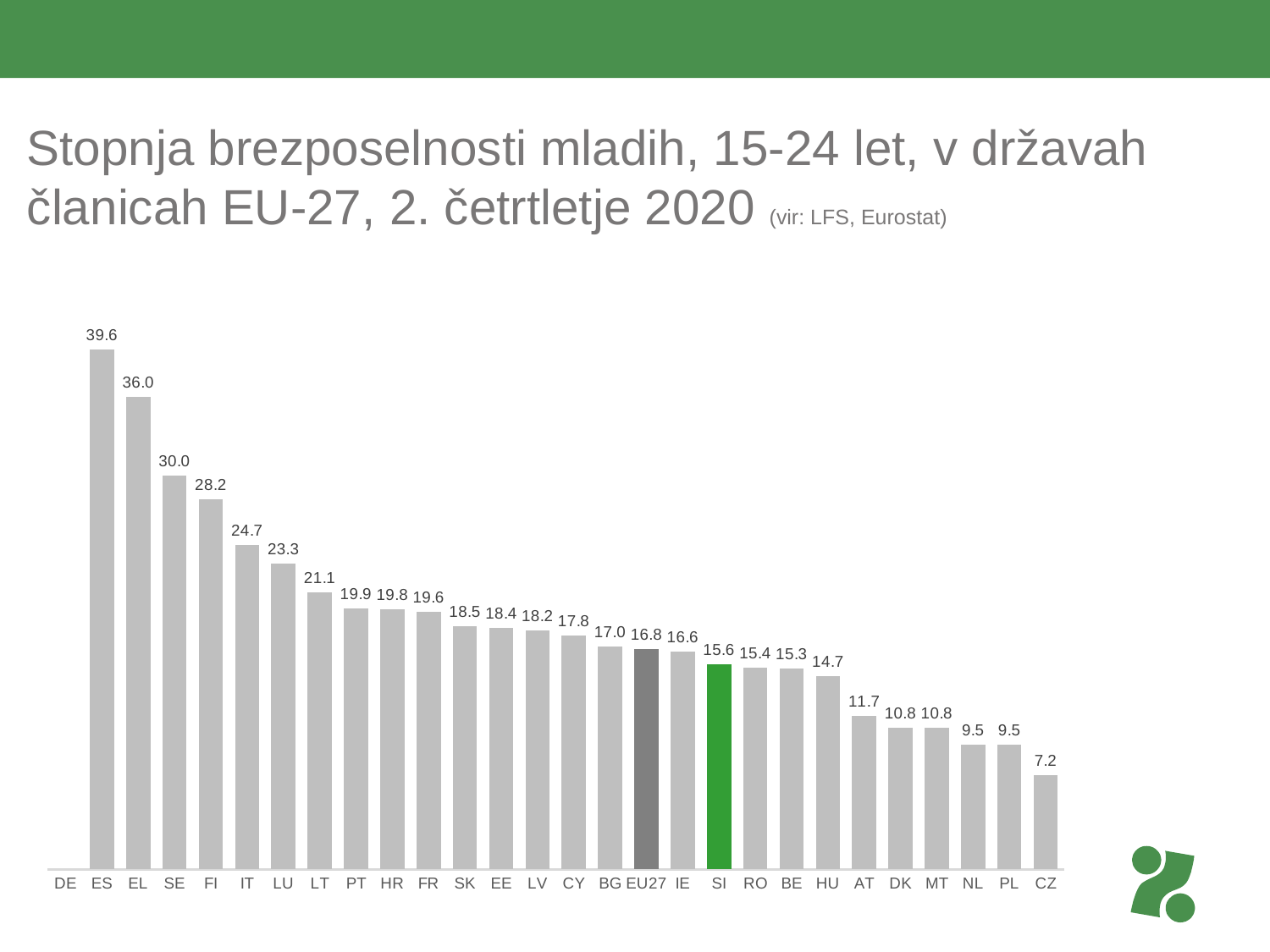
What is the value for SI? 15.6 What is the difference between the values for ES and CZ? 32.4 Which country has the highest value? ES What is the value for HU? 14.7 Do the values rise or fall from left to right along the x axis? fall Which country's bar is coloured green? SI What is the difference between the values for EU27 and SI? 1.2 What is the value for EU27? 16.8 Which is larger, the value for SI or the value for EU27? EU27 Which is larger, the value for IT or the value for LU? IT Which country has the lowest value? CZ What kind of chart is shown on the slide? bar chart